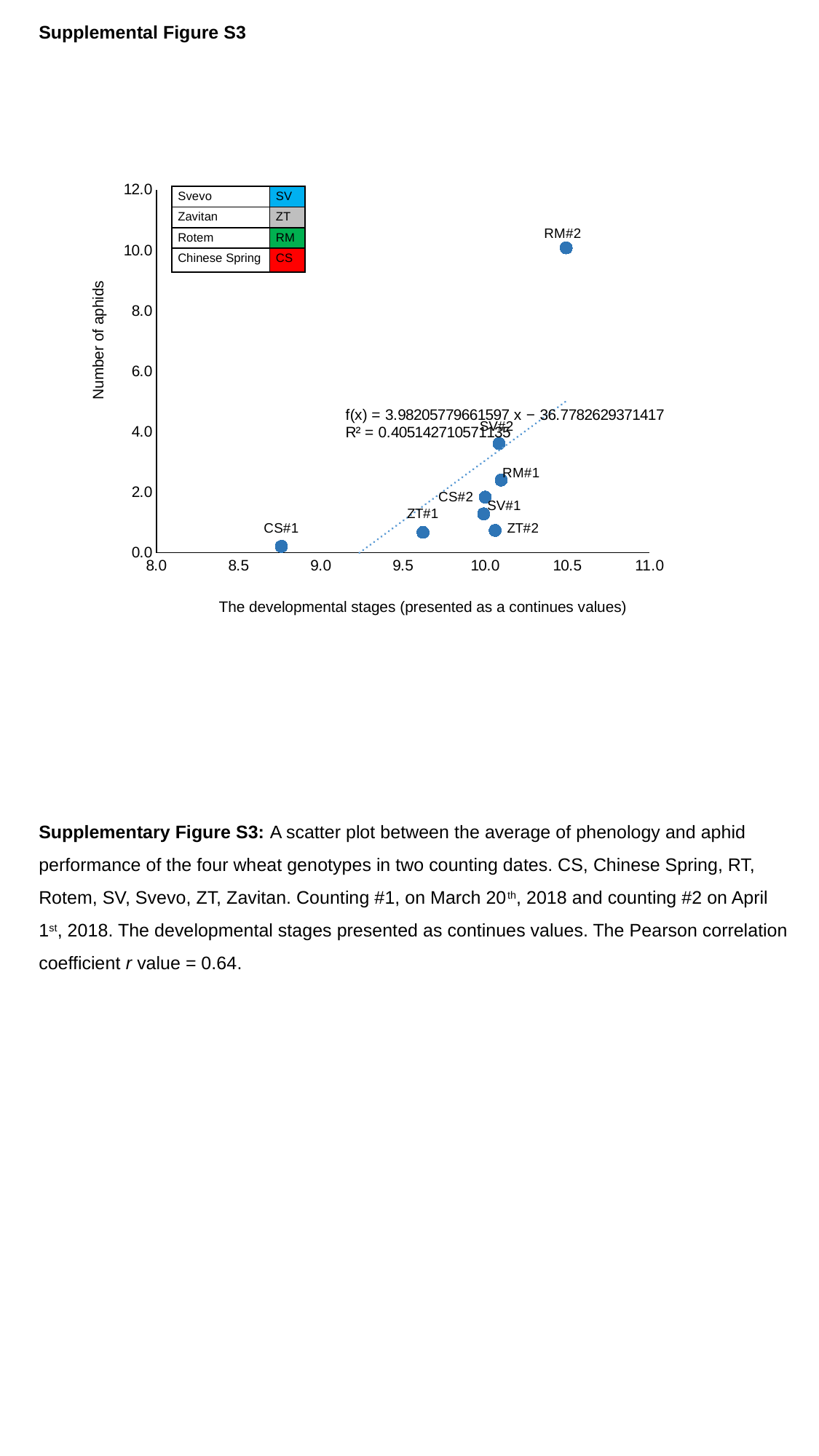
What is the R² value printed on the chart? 0.405142710571135 How many labeled data points are plotted on the chart? 8 Is the number of aphids for RM#2 greater or less than 8.0? greater Is the number of aphids for RM#1 greater or less than 2.0? greater What kind of chart is shown on the slide? Scatter plot Which has a higher number of aphids, CS#1 or ZT#1? ZT#1 Is the developmental stage value (x axis) for CS#1 greater or less than 9.0? less Which data point has the lowest number of aphids? CS#1 Which data point has the highest number of aphids? RM#2 Which has a higher number of aphids, RM#2 or SV#2? RM#2 According to the fitted trend line, does the number of aphids rise or fall as the developmental stage increases? Rise